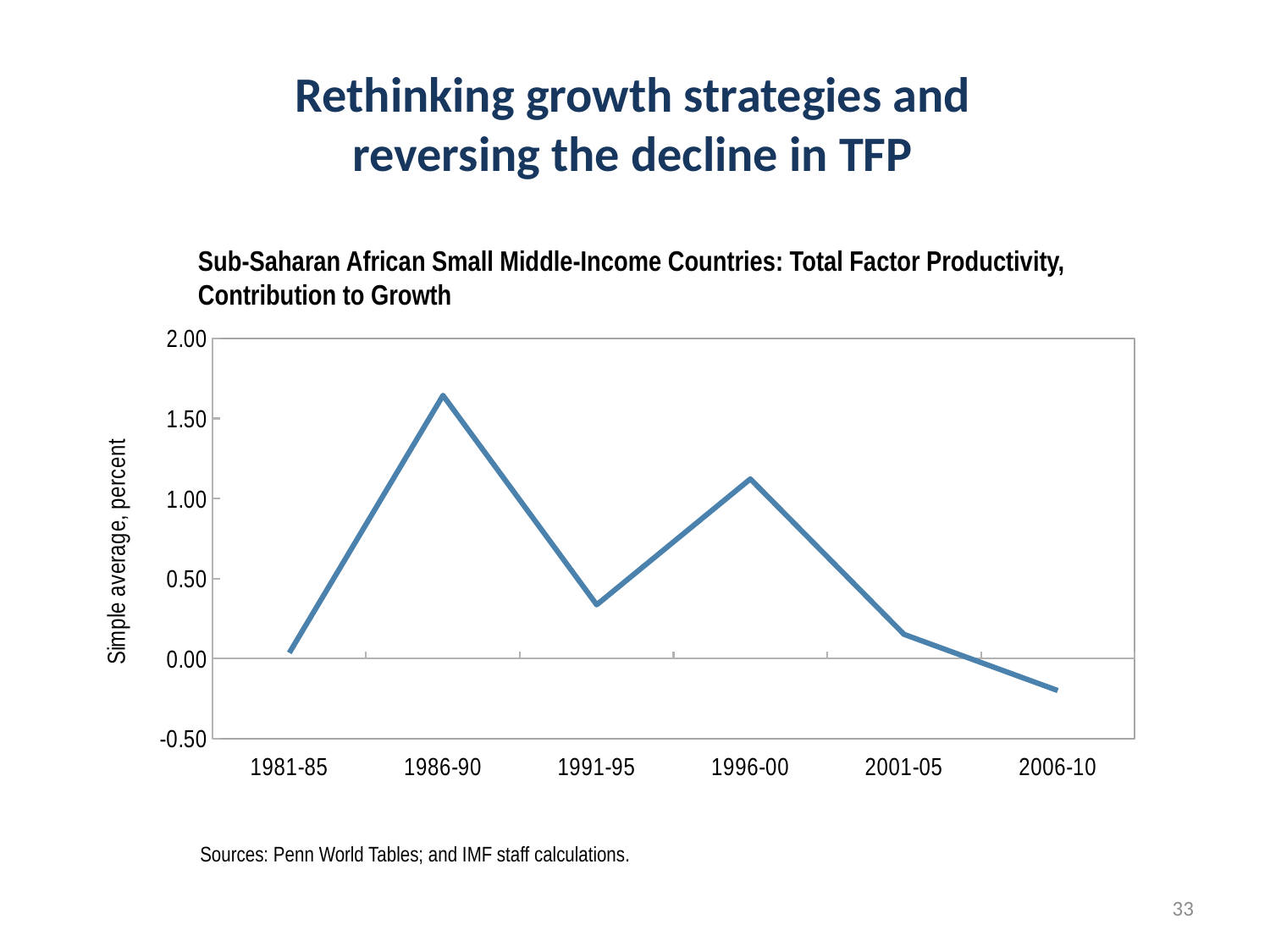
Is the value for 2006-10 greater or less than 0.00? less Which is larger, the value for 1991-95 or the value for 2001-05? 1991-95 How many time periods are plotted along the x axis? 6 Which period has the highest value? 1986-90 Which is larger, the value for 1986-90 or the value for 1996-00? 1986-90 What is the label on the vertical axis? Simple average, percent Which period has the lowest value? 2006-10 Is the value for 1991-95 greater or less than 0.50? less Is the value for 1986-90 greater or less than 1.50? greater Does the line rise or fall from 1996-00 to 2006-10? fall What kind of chart is shown on the slide? line chart